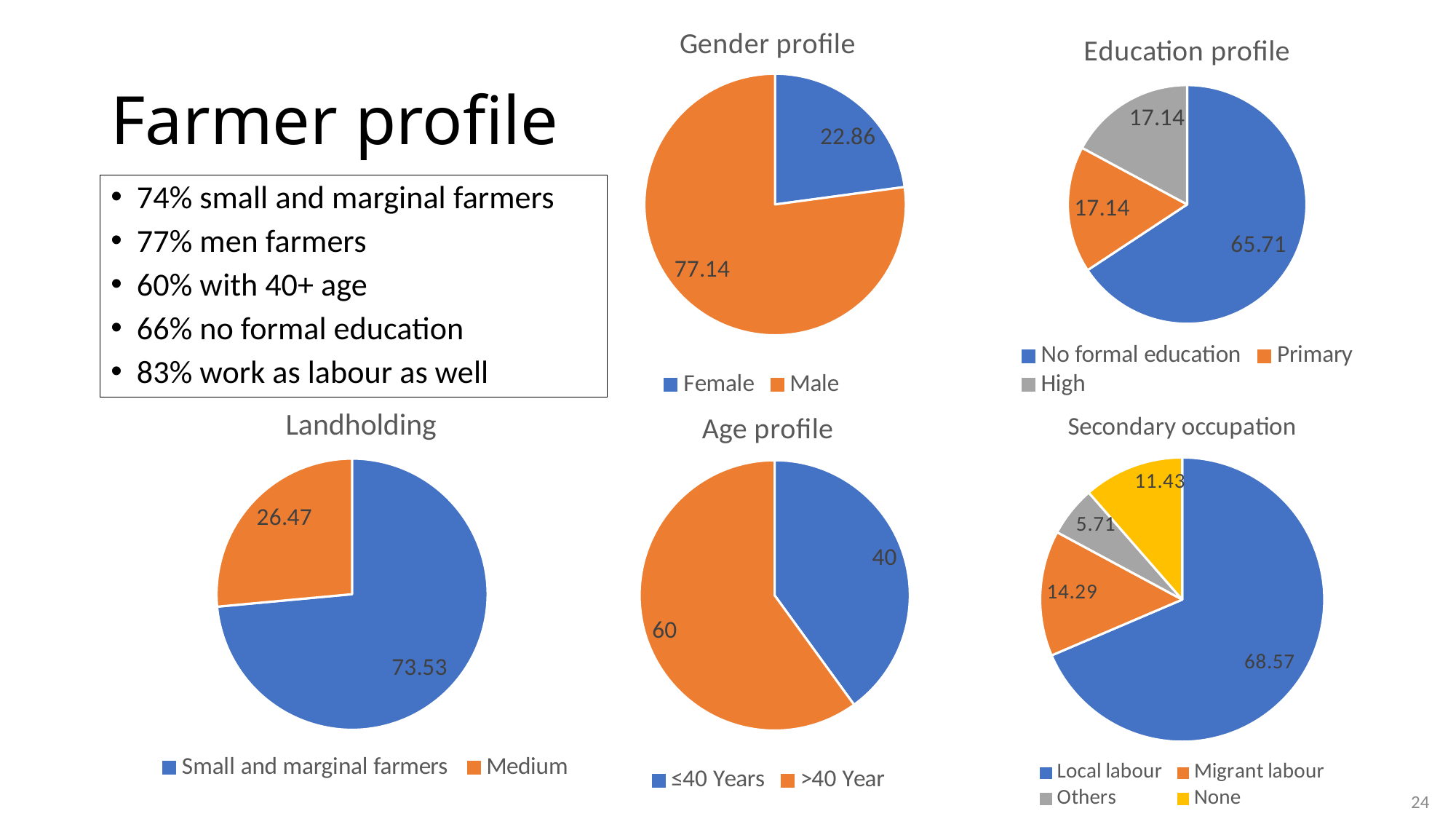
In the Age profile chart, which category is largest? >40 Year In the Secondary occupation chart, which category is smallest? Others What kind of chart is the Landholding chart? Pie chart In the Secondary occupation chart, which is larger, Migrant labour or None? Migrant labour In the Gender profile chart, what is the value for Male? 77.14 In the Education profile chart, what is the value for No formal education? 65.71 In the Secondary occupation chart, what is the value for None? 11.43 In the Landholding chart, what is the difference between Small and marginal farmers and Medium? 47.06 In the Landholding chart, what is the value for Medium? 26.47 In the Age profile chart, what is the value for ≤40 Years? 40 In the Gender profile chart, what is the value for Female? 22.86 In the Education profile chart, how many categories does the legend list? 3